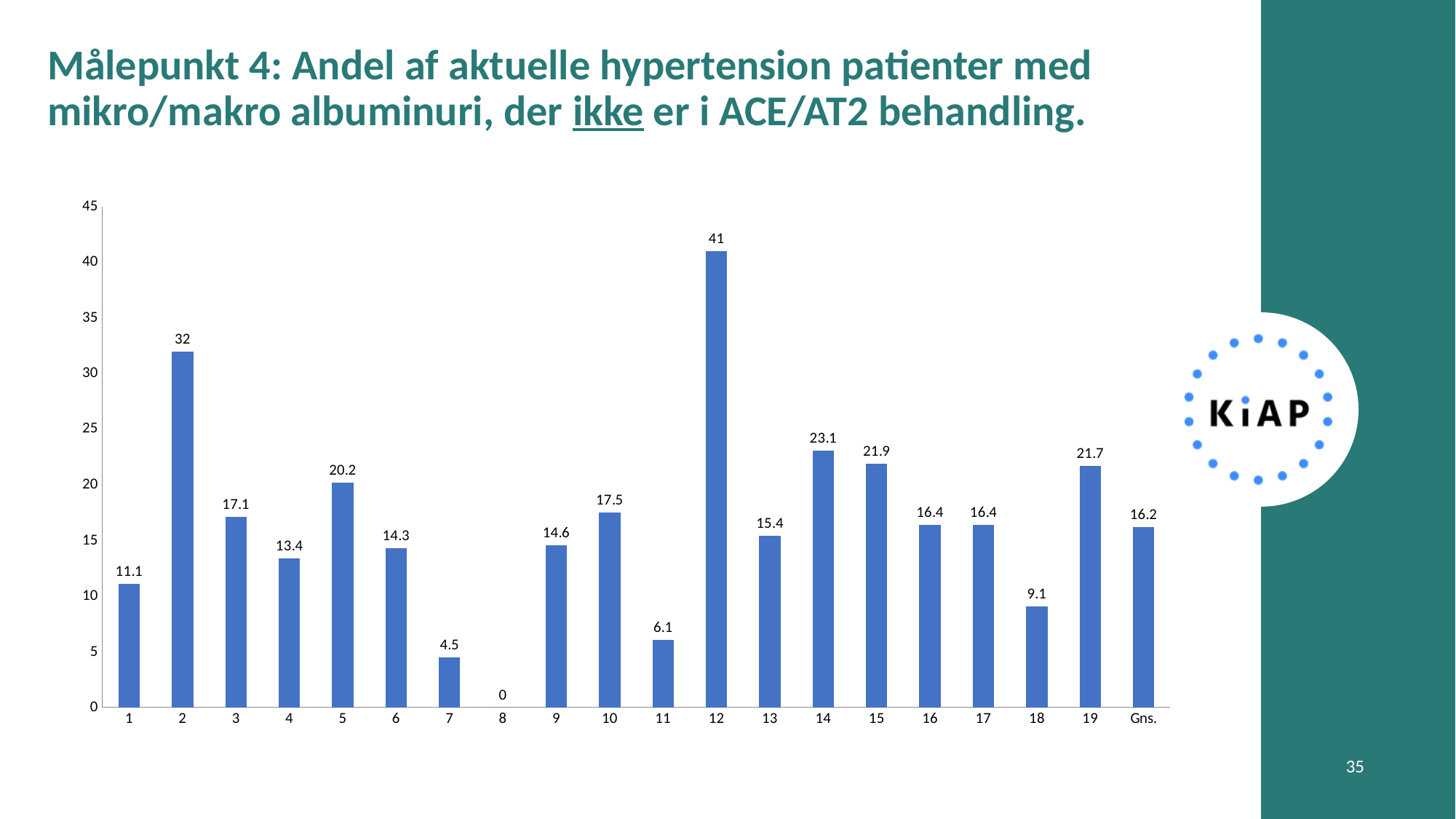
Is the value for category 5 greater or less than 15? greater Which is larger, the value for category 14 or category 15? 14 What is the difference between the values for category 2 and category 12? 9 Which category has the highest value? 12 How many categories are shown on the x axis? 20 What is the value for category 12? 41 What is the maximum value shown on the y axis? 45 What is the value shown for Gns.? 16.2 What is the value for category 7? 4.5 What kind of chart is this? bar chart Which category has the lowest value? 8 What is the difference between the value for category 19 and the Gns. value? 5.5